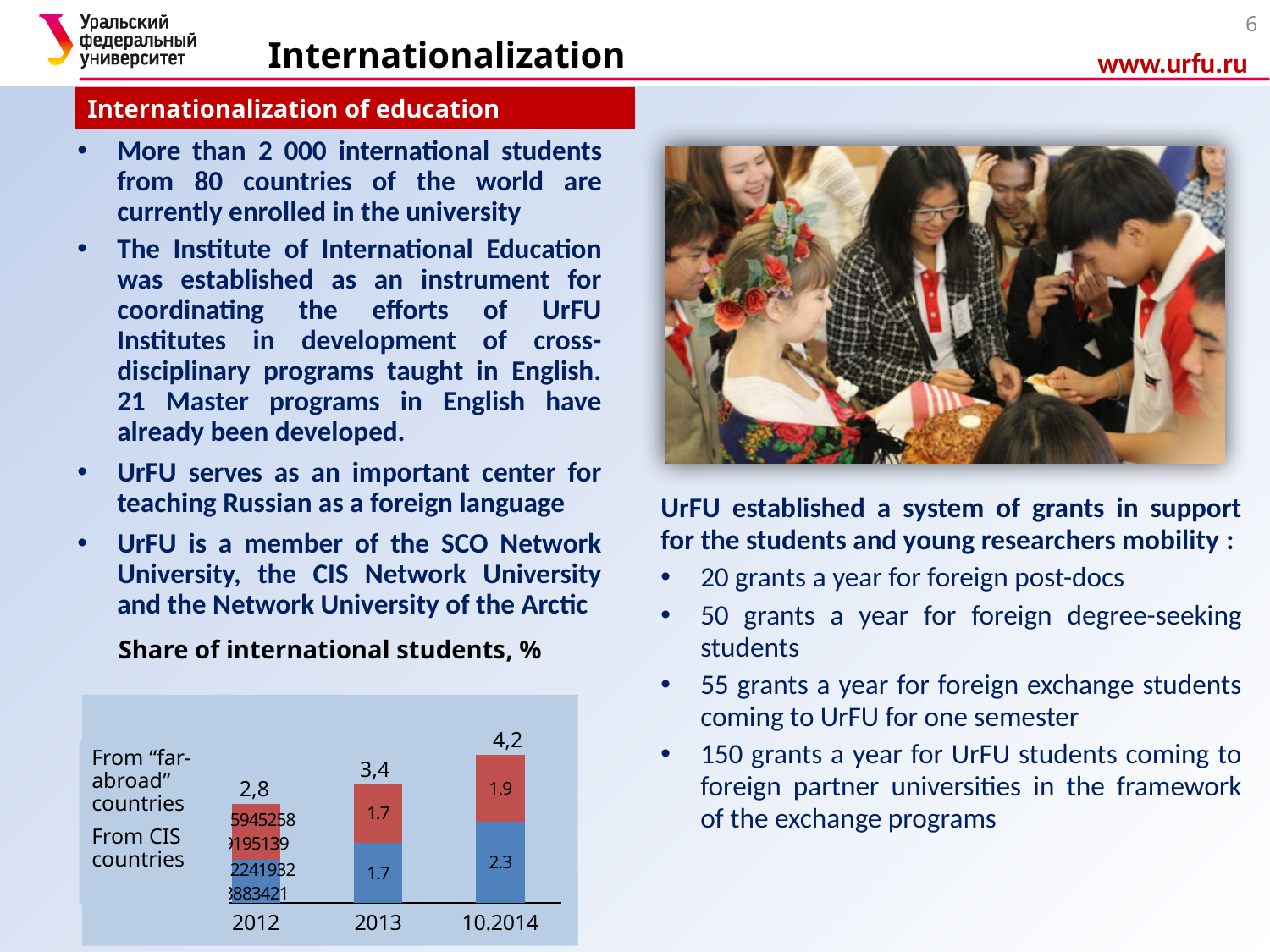
What is the value for students from "far-abroad" countries in 10.2014? 1.9 What is the total share of international students shown for 2012? 2,8 What is the total share of international students shown for 2013? 3,4 How many series does the chart's legend list? 2 What is the value for students from CIS countries in 10.2014? 2.3 What is the total share of international students shown for 10.2014? 4,2 How many time periods are shown on the x axis of the chart? 3 Does the total share of international students rise or fall from 2012 to 10.2014? rise What type of chart is shown under the title "Share of international students, %"? stacked bar chart Which year has the highest total share of international students? 10.2014 What is the value for students from "far-abroad" countries in 2013? 1.7 Which year has the lowest total share of international students? 2012